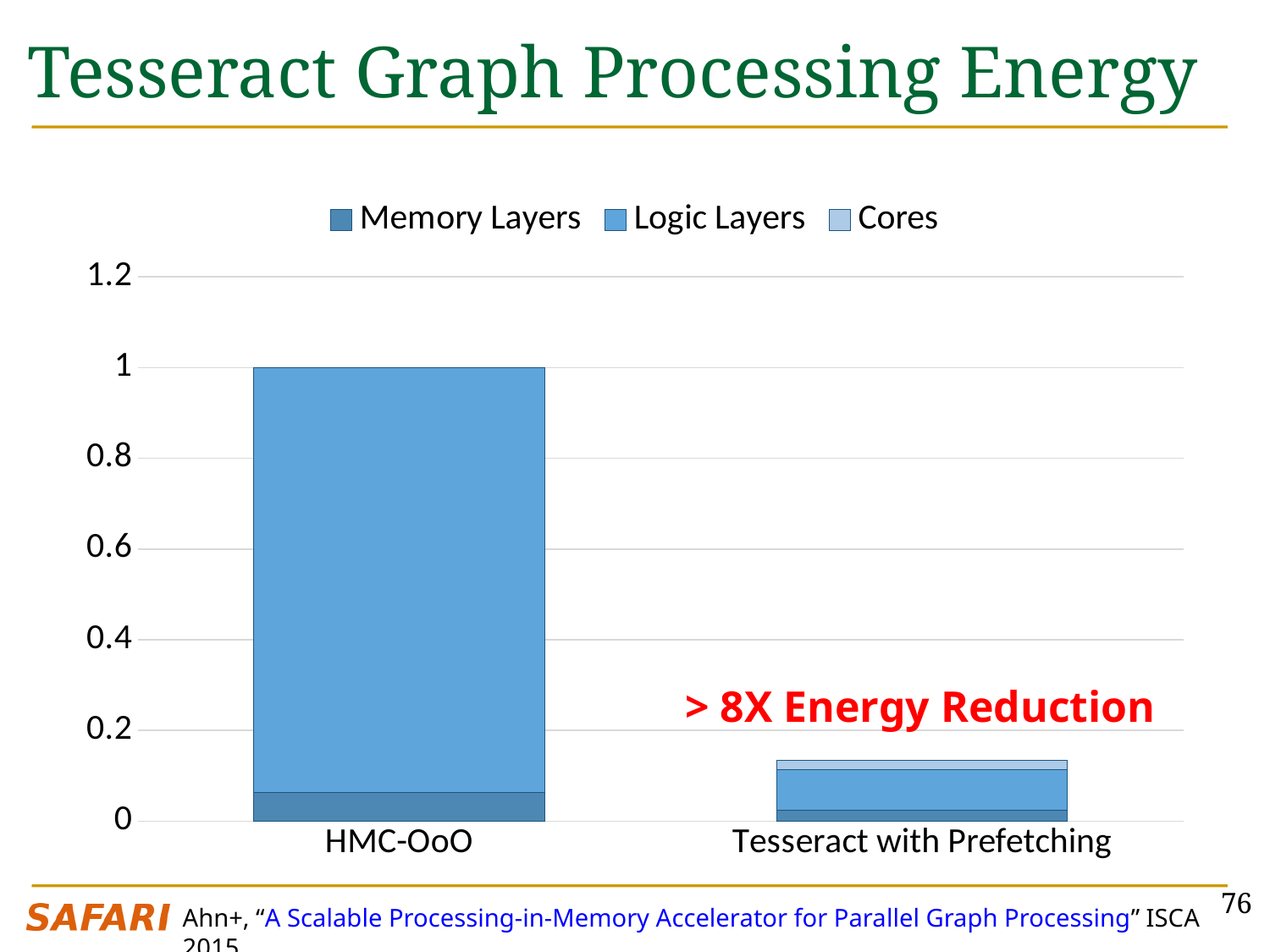
How many categories are shown on the x axis? 2 What kind of chart is shown on the slide? bar chart Is the total value for HMC-OoO greater or less than 0.8? greater How many series does the legend list? 3 Is the total value for Tesseract with Prefetching greater or less than 0.2? less Which category has the highest total energy? HMC-OoO Which is larger, the total for HMC-OoO or the total for Tesseract with Prefetching? HMC-OoO Which category has the lowest total energy? Tesseract with Prefetching What is the total height of the stacked bar for HMC-OoO? 1 Do the total values rise or fall from HMC-OoO to Tesseract with Prefetching? fall Which series are listed in the legend? Memory Layers, Logic Layers, Cores What is the title of the slide containing the chart? Tesseract Graph Processing Energy